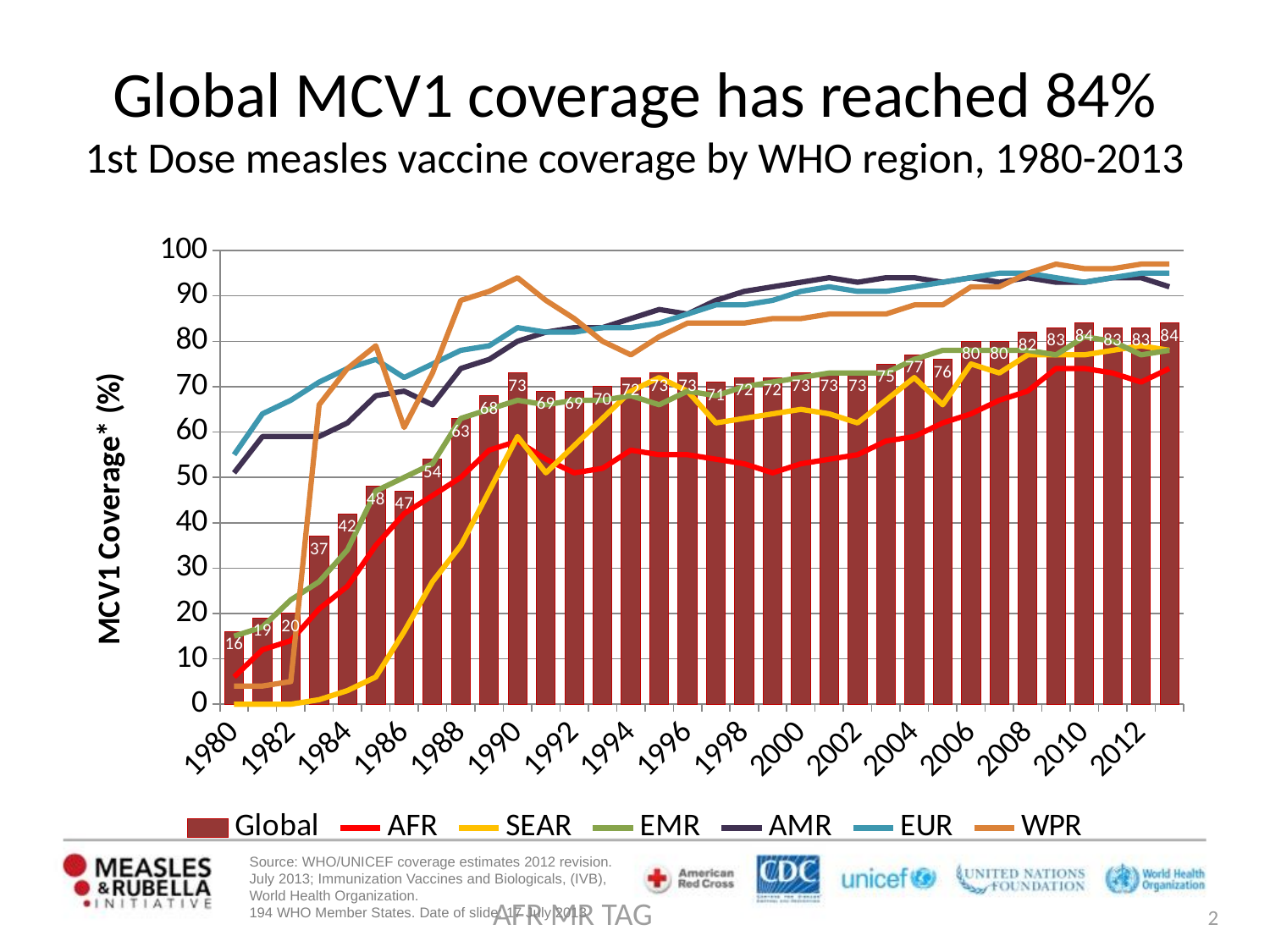
Which year has the larger Global value, 1990 or 1991? 1990 Is the WPR value for 2013 greater or less than 90? greater Is the SEAR value for 1980 greater or less than 10? less Do the Global bars generally rise or fall from 1980 to 2013? rise By how many percentage points did the Global value increase from 1980 to 2013? 68 How many series does the legend list? 7 What is the Global MCV1 coverage value shown for 1980? 16 What is the Global MCV1 coverage value shown for 1990? 73 What is the highest Global value labelled on the bars? 84 In which year is the Global bar lowest? 1980 What is the label on the vertical axis? MCV1 Coverage* (%) What is the Global MCV1 coverage value shown for 2013? 84